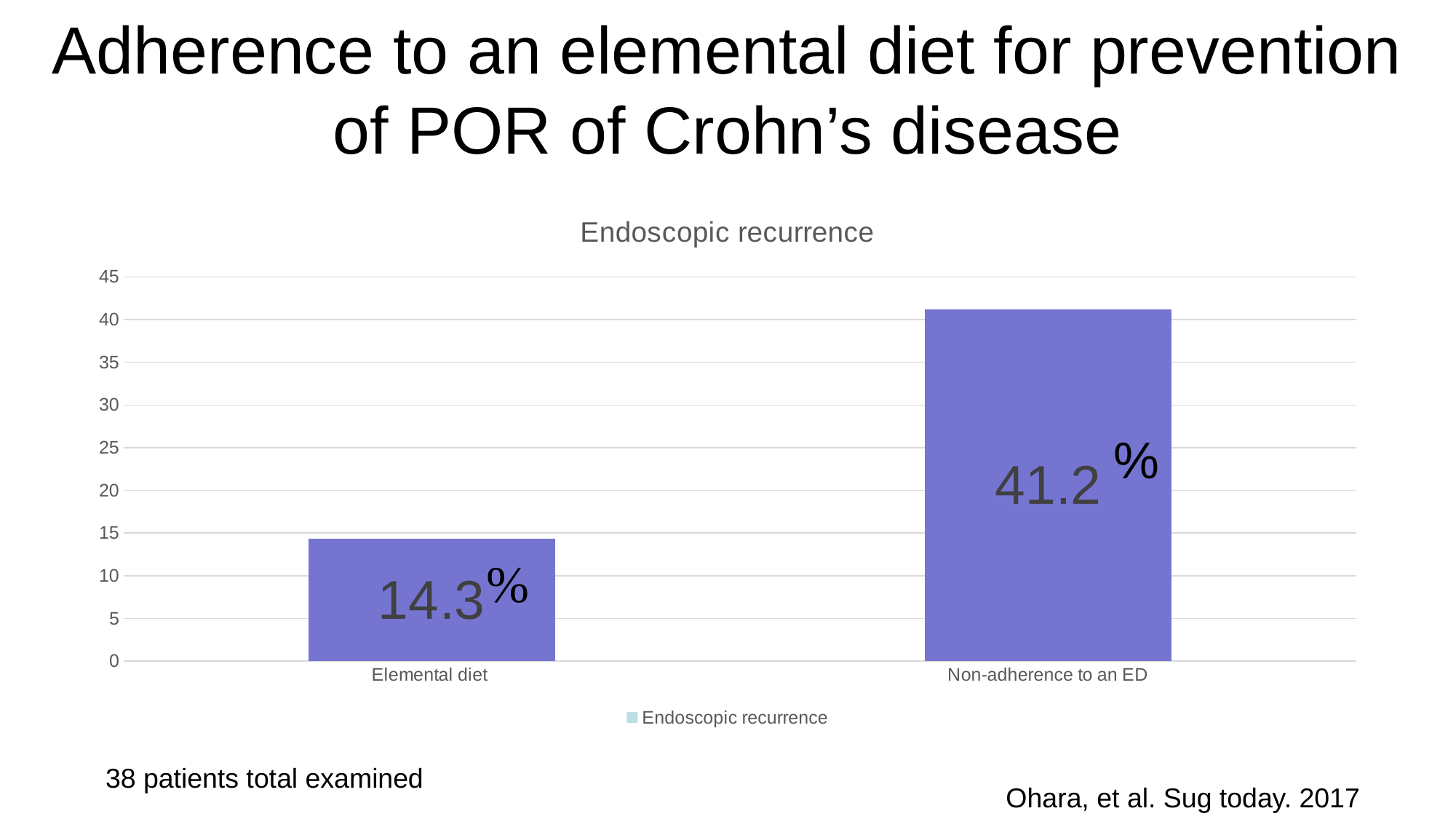
Is the value for Non-adherence to an ED greater or less than 40? greater What kind of chart is shown on the slide? bar chart What is the difference in endoscopic recurrence between Non-adherence to an ED and Elemental diet? 26.9% Which category has the highest endoscopic recurrence? Non-adherence to an ED How many categories are shown on the x axis? 2 What is the endoscopic recurrence value for Non-adherence to an ED? 41.2% Which category has the lowest endoscopic recurrence? Elemental diet What is the title of the chart? Endoscopic recurrence How many series does the legend list? 1 What is the endoscopic recurrence value for Elemental diet? 14.3% Is the value for Elemental diet greater or less than 15? less Which is larger, the value for Elemental diet or the value for Non-adherence to an ED? Non-adherence to an ED